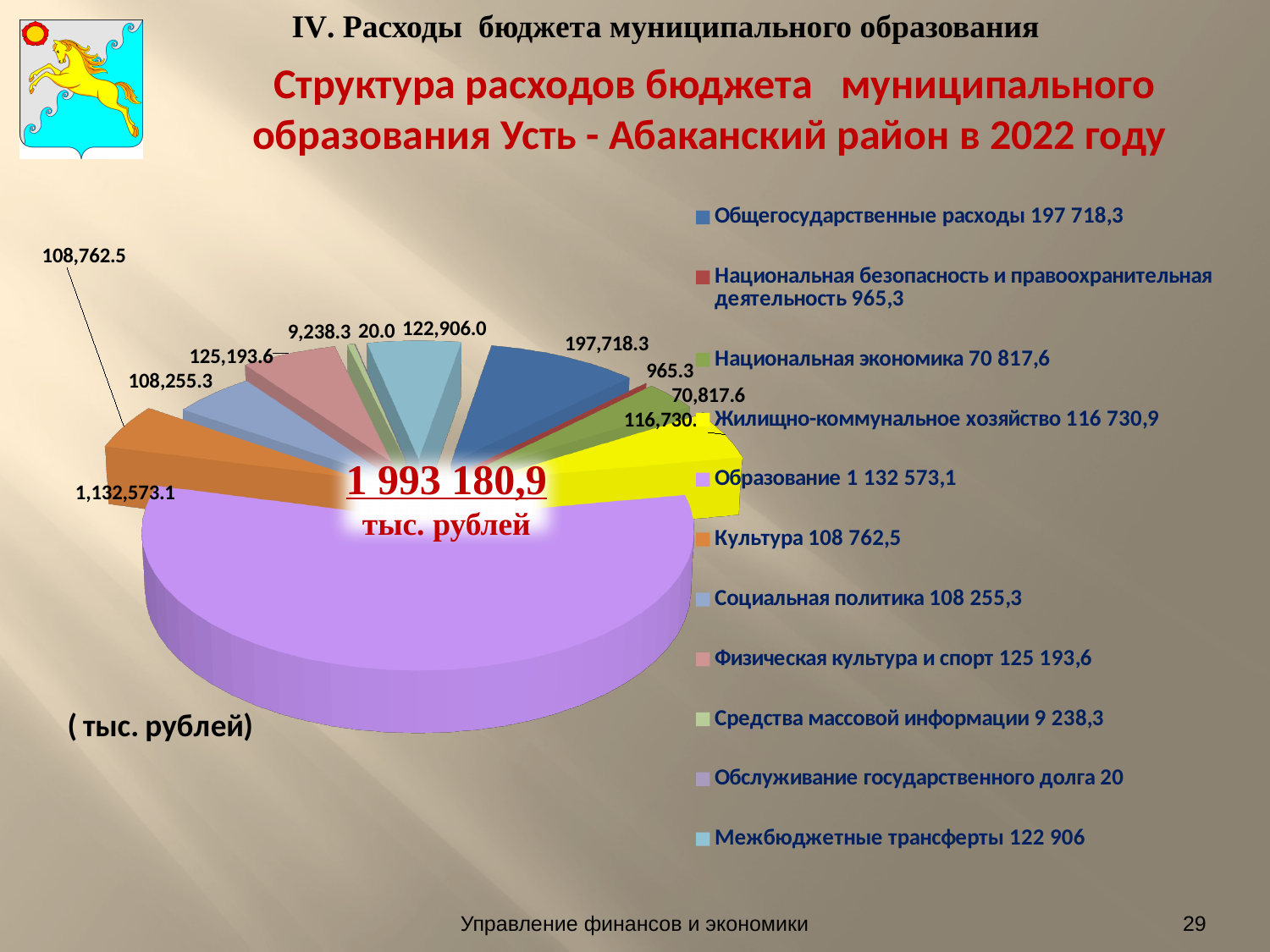
What is the value for Образование in the pie chart? 1,132,573.1 Which is larger, Культура or Социальная политика? Культура What kind of chart is shown on the slide? Pie chart What share of the total 1 993 180,9 does Образование represent? 56.8% Which category has the largest slice of the pie chart? Образование What is the value for Общегосударственные расходы in the pie chart? 197,718.3 Which category has the smallest value in the pie chart? Обслуживание государственного долга What is the value for Национальная безопасность и правоохранительная деятельность? 965.3 What total value is printed in the centre of the pie chart? 1 993 180,9 тыс. рублей What is the difference between Физическая культура и спорт and Межбюджетные трансферты? 2,287.6 What is the difference between Общегосударственные расходы and Жилищно-коммунальное хозяйство? 80,987.4 How many categories does the pie chart show? 11